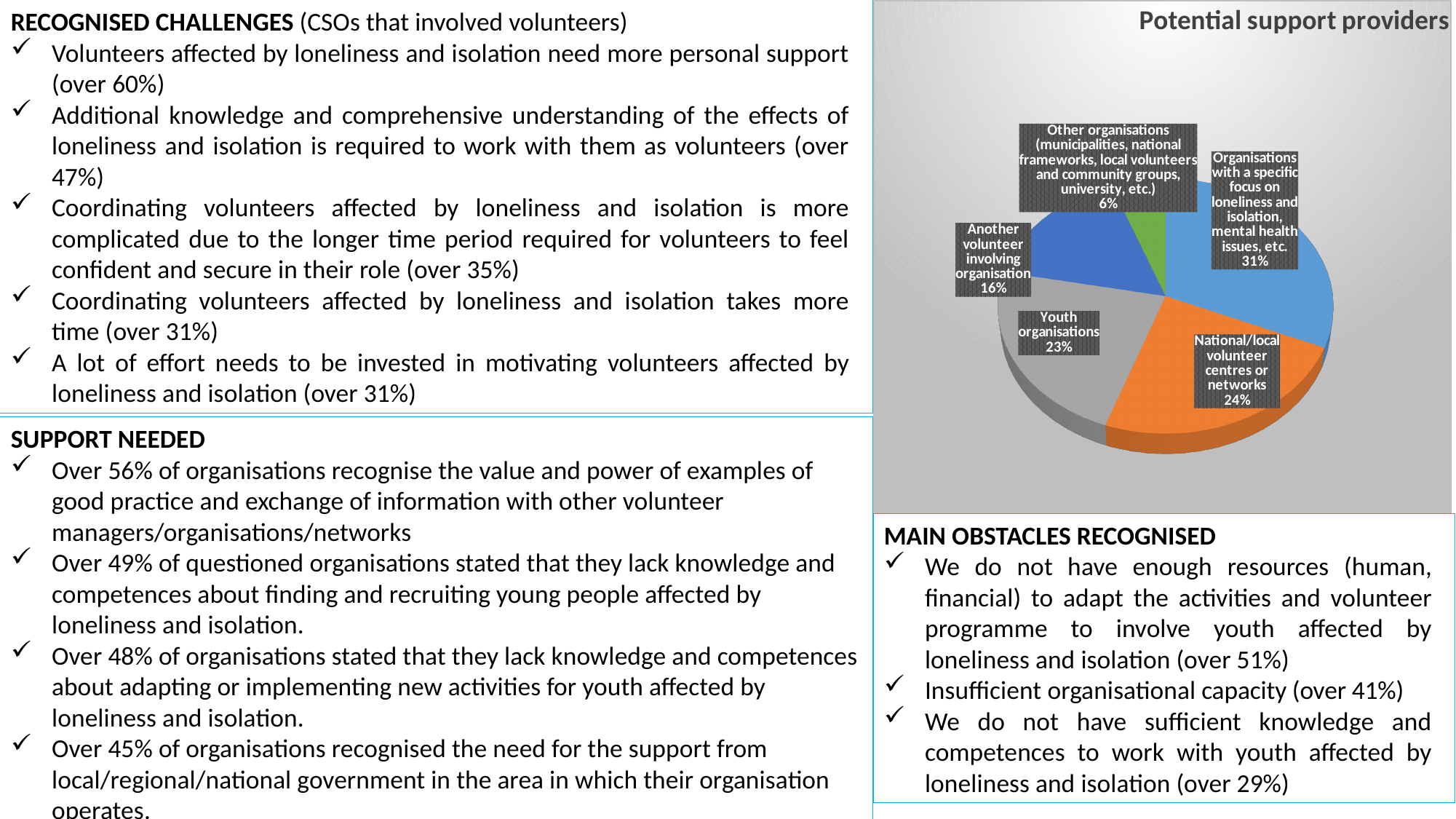
What is the title of the pie chart on the slide? Potential support providers What type of chart is shown under the title "Potential support providers"? Pie chart What percentage does the pie chart show for "Youth organisations"? 23% In the pie chart, which is larger: "National/local volunteer centres or networks" or "Another volunteer involving organisation"? National/local volunteer centres or networks Which category has the smallest slice in the pie chart? Other organisations (municipalities, national frameworks, local volunteers and community groups, university, etc.) Which category has the largest slice in the pie chart? Organisations with a specific focus on loneliness and isolation, mental health issues, etc. How many slices does the pie chart have? 5 What is the difference in percentage points between "Organisations with a specific focus on loneliness and isolation, mental health issues, etc." and "Another volunteer involving organisation" in the pie chart? 15 percentage points What percentage does the pie chart show for "Other organisations (municipalities, national frameworks, local volunteers and community groups, university, etc.)"? 6% What percentage does the pie chart show for "National/local volunteer centres or networks"? 24% What percentage does the pie chart show for "Another volunteer involving organisation"? 16% What share of the pie chart is labelled "Organisations with a specific focus on loneliness and isolation, mental health issues, etc."? 31%